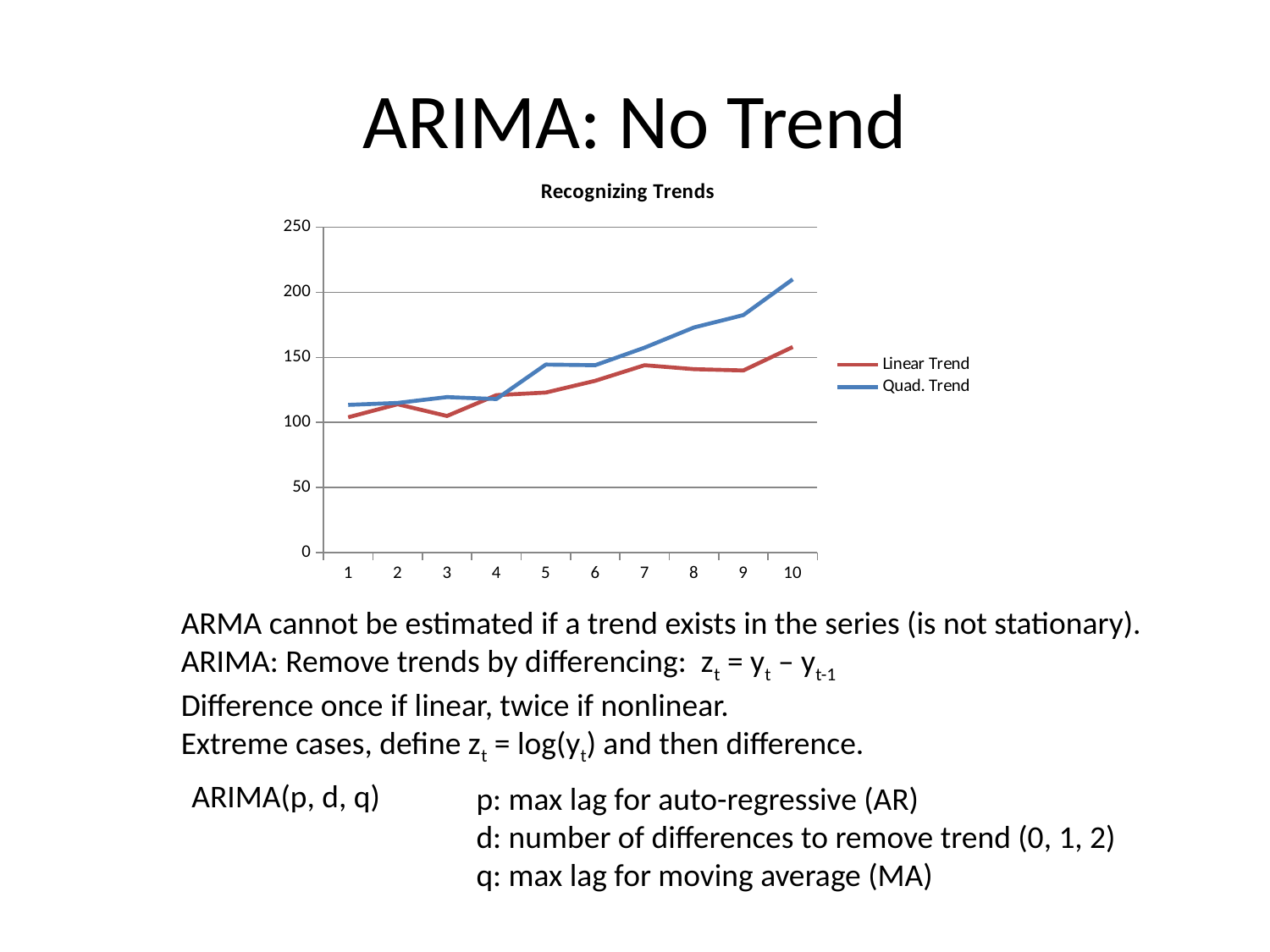
At which x value does the Quad. Trend series reach its highest point? 10 Does the Quad. Trend series generally rise or fall from x = 1 to x = 10? rise How many series does the legend list? 2 Is the Quad. Trend value at x = 9 greater or less than 150? greater How many points are plotted along the x axis for each series? 10 Is the Quad. Trend value at x = 10 greater or less than 200? greater At x = 10, which series has the larger value, Linear Trend or Quad. Trend? Quad. Trend Which series is drawn in blue? Quad. Trend Is the Linear Trend value at x = 5 greater or less than 100? greater What kind of chart is shown on the slide? line chart What is the title of the chart? Recognizing Trends